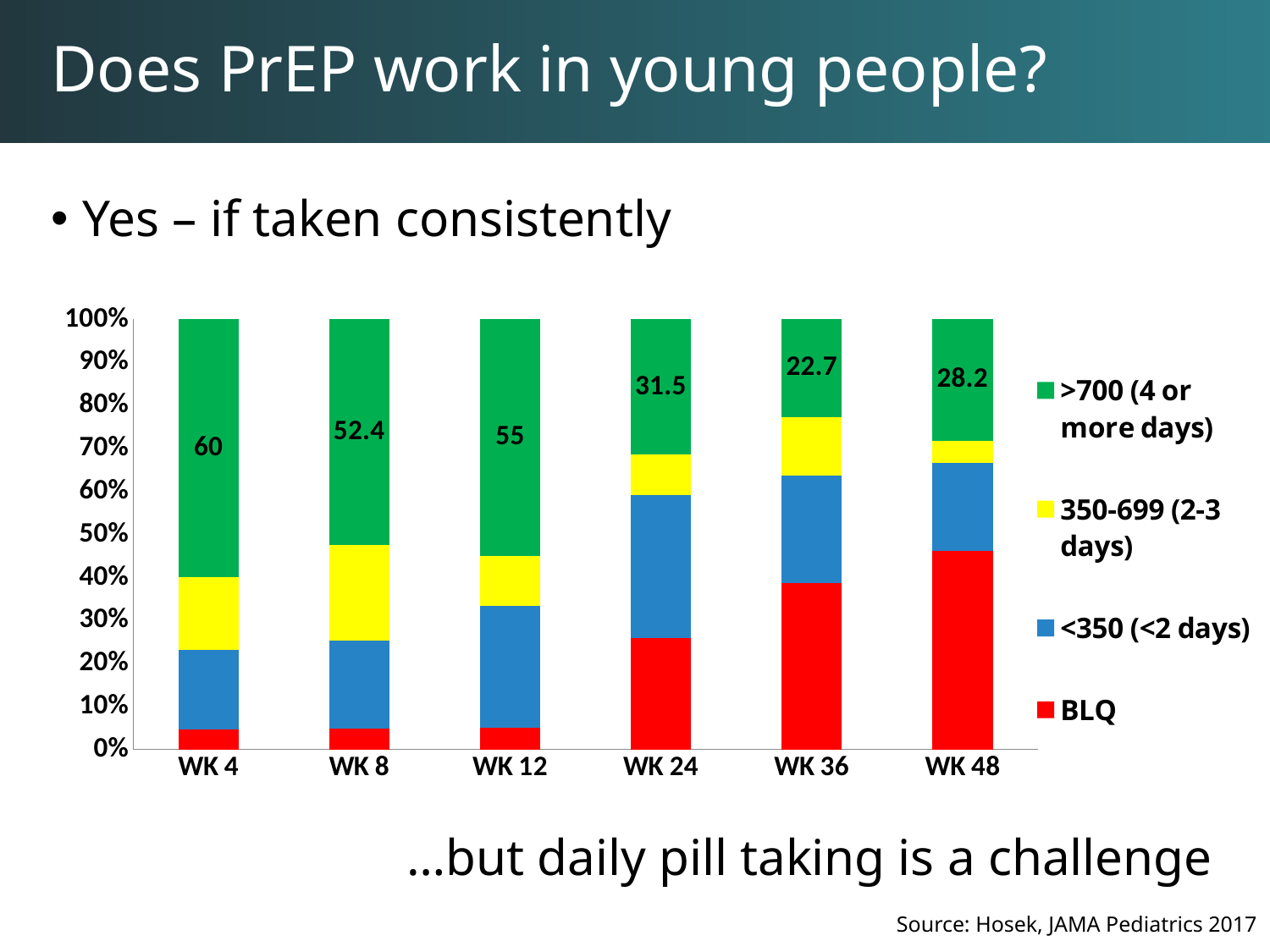
Which has the larger ">700 (4 or more days)" value, WK 36 or WK 48? WK 48 How many week categories are shown on the x axis? 6 What is the value of the ">700 (4 or more days)" series at WK 8? 52.4 Is the BLQ share at WK 48 greater or less than 40%? greater At which week is the ">700 (4 or more days)" value lowest? WK 36 What is the value of the ">700 (4 or more days)" series at WK 48? 28.2 What is the difference between the ">700 (4 or more days)" values at WK 4 and WK 8? 7.6 At which week is the ">700 (4 or more days)" value highest? WK 4 How many series does the legend list? 4 What is the value of the ">700 (4 or more days)" series at WK 24? 31.5 What kind of chart is shown on the slide? Stacked bar chart What is the value of the ">700 (4 or more days)" series at WK 4? 60